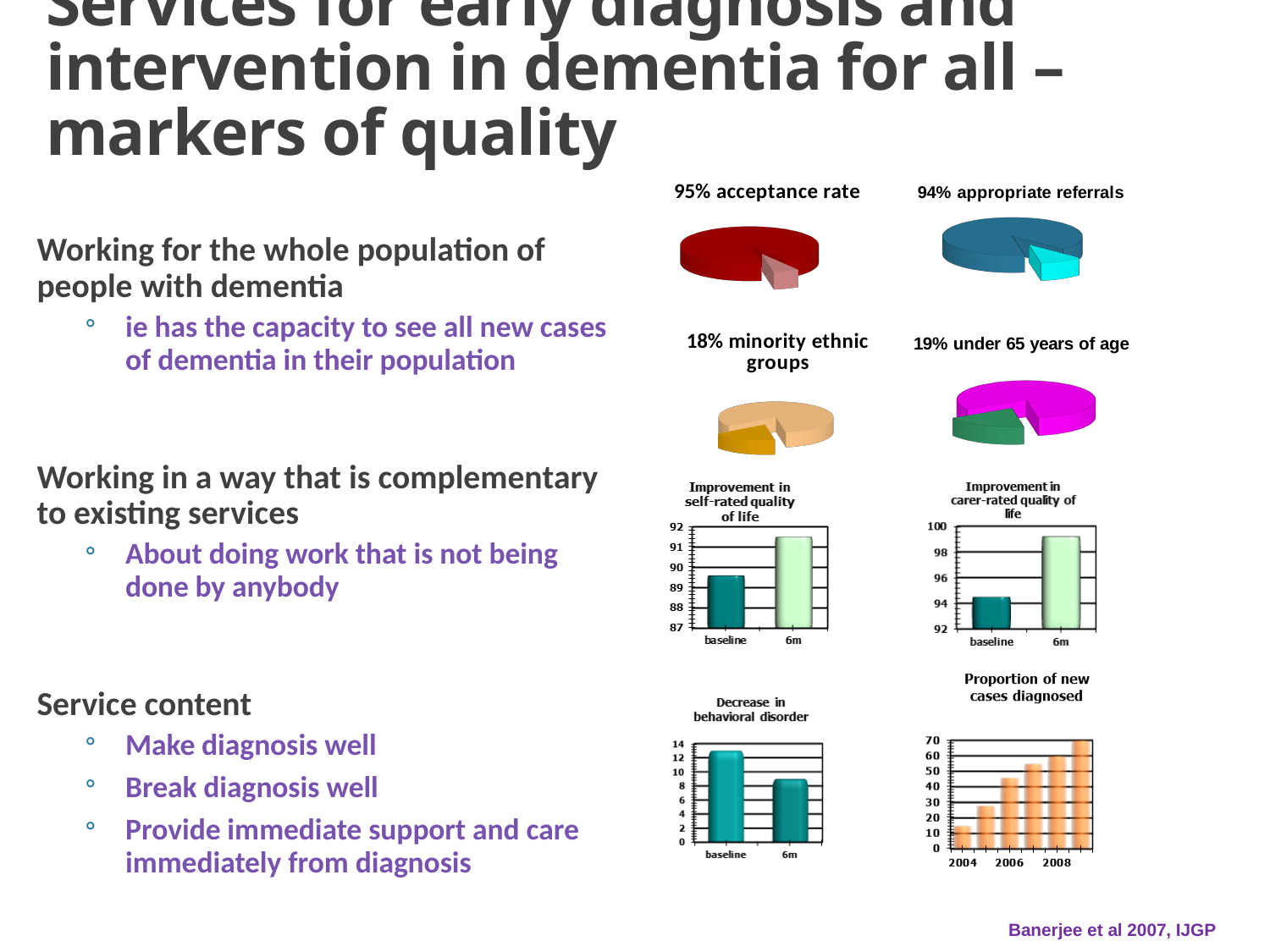
In the chart titled 'Improvement in self-rated quality of life', how many categories are shown on the x axis? 2 In the chart titled 'Improvement in self-rated quality of life', which category has the higher value, baseline or 6m? 6m In the chart titled 'Proportion of new cases diagnosed', how many bars are plotted? 6 In the chart titled 'Decrease in behavioral disorder', is the value for 6m greater or less than 10? less What kind of chart is the one titled '95% acceptance rate'? pie chart In the chart titled 'Decrease in behavioral disorder', do the values rise or fall from baseline to 6m? fall In the chart titled 'Improvement in carer-rated quality of life', is the value for baseline greater or less than 96? less What kind of chart is the one titled 'Proportion of new cases diagnosed'? bar chart In the chart titled 'Improvement in carer-rated quality of life', is the value for 6m greater or less than 98? greater In the chart titled 'Proportion of new cases diagnosed', do the values rise or fall from left to right along the x axis? rise